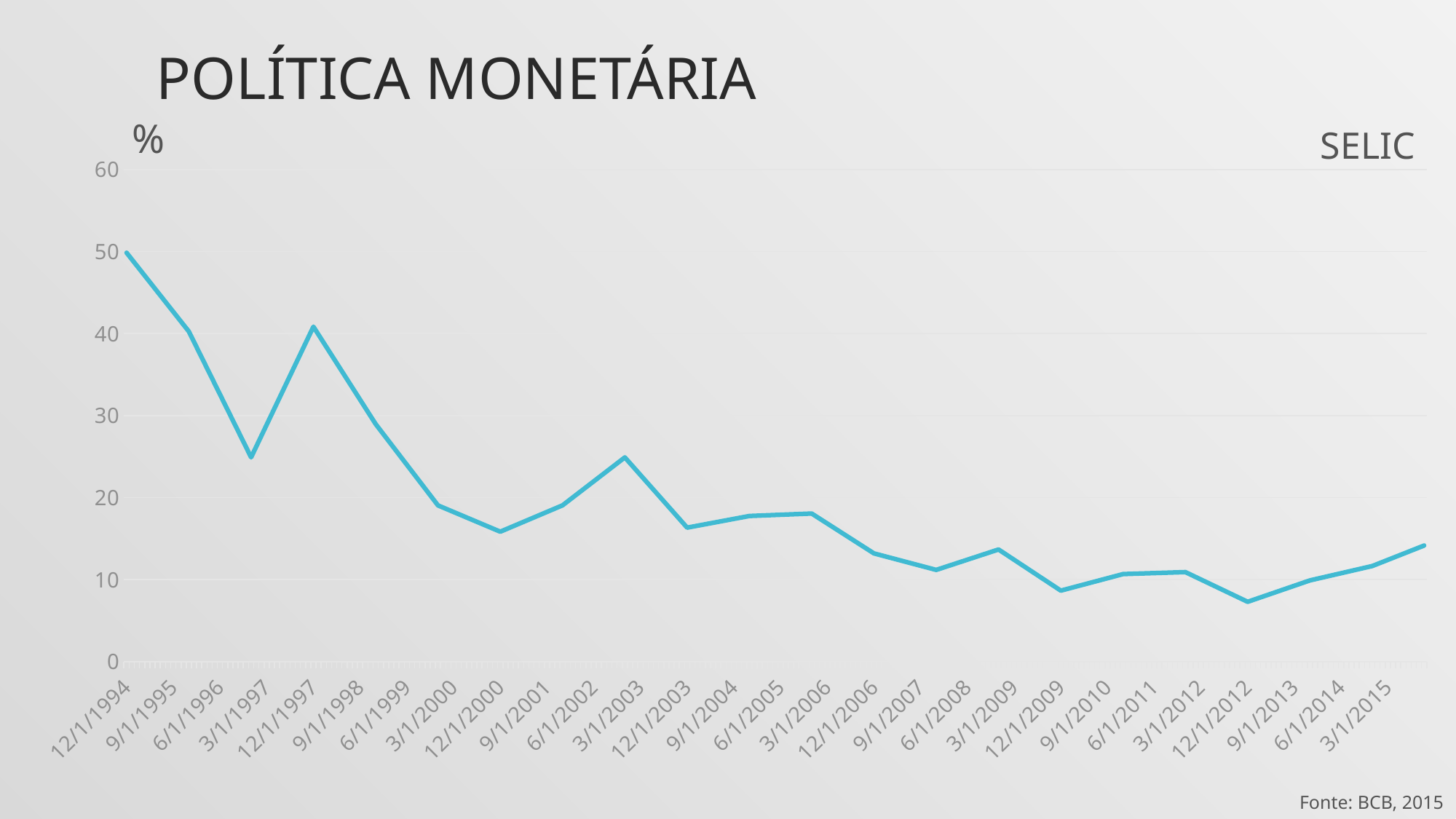
What is the title of the chart? SELIC Is the value for 3/1/2003 greater or less than 20? greater At which date does the SELIC line reach its lowest value? 12/1/2012 What kind of chart is shown on the slide? line chart Is the value for 12/1/2012 greater or less than 10? less Which is larger, the value for 12/1/1994 or the value for 12/1/1997? 12/1/1994 At which date does the SELIC line reach its highest value? 12/1/1994 What unit is shown on the y axis of the chart? % Which is larger, the value for 3/1/2003 or the value for 12/1/2003? 3/1/2003 Is the value for 3/1/1997 greater or less than 30? less Overall, does the SELIC line rise or fall from 12/1/1994 to 3/1/2015? fall